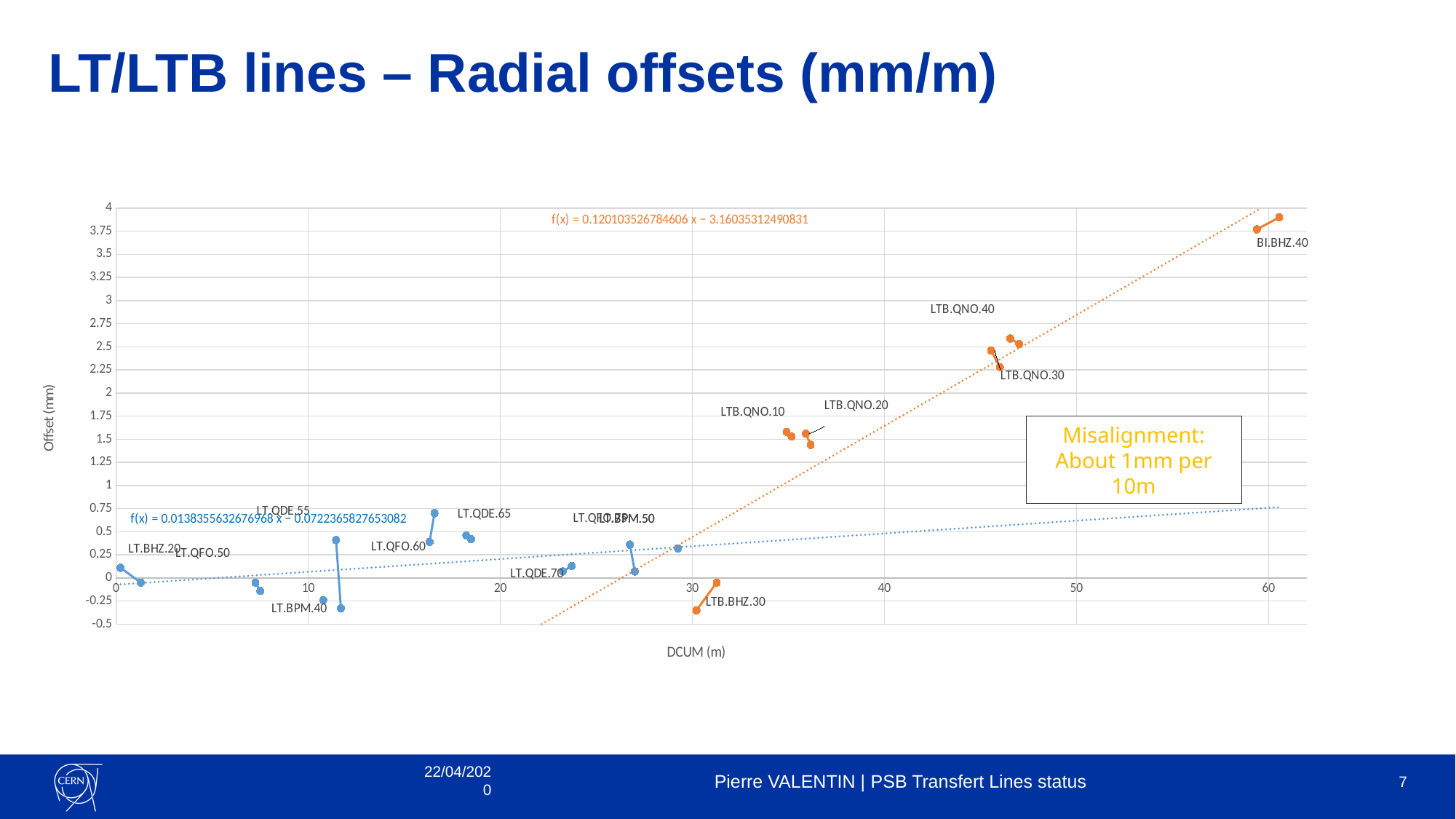
Is the offset for LT.QDE.55 greater or less than 1 mm? less Is the lowest point of LTB.BHZ.30 greater or less than 0 mm? less Which has a larger offset, LTB.QNO.10 or LT.QDE.55? LTB.QNO.10 Is the offset for LTB.QNO.40 greater or less than 2.25 mm? greater Do the orange (LTB) points generally rise or fall as DCUM increases? rise What does the text box on the chart say about the misalignment? About 1mm per 10m Which labelled element has the highest radial offset on the chart? BI.BHZ.40 What is the slope of the orange trend line equation shown on the chart? 0.120103526784606 Which has a larger offset, BI.BHZ.40 or LTB.QNO.40? BI.BHZ.40 What kind of chart is shown on the slide? Scatter chart